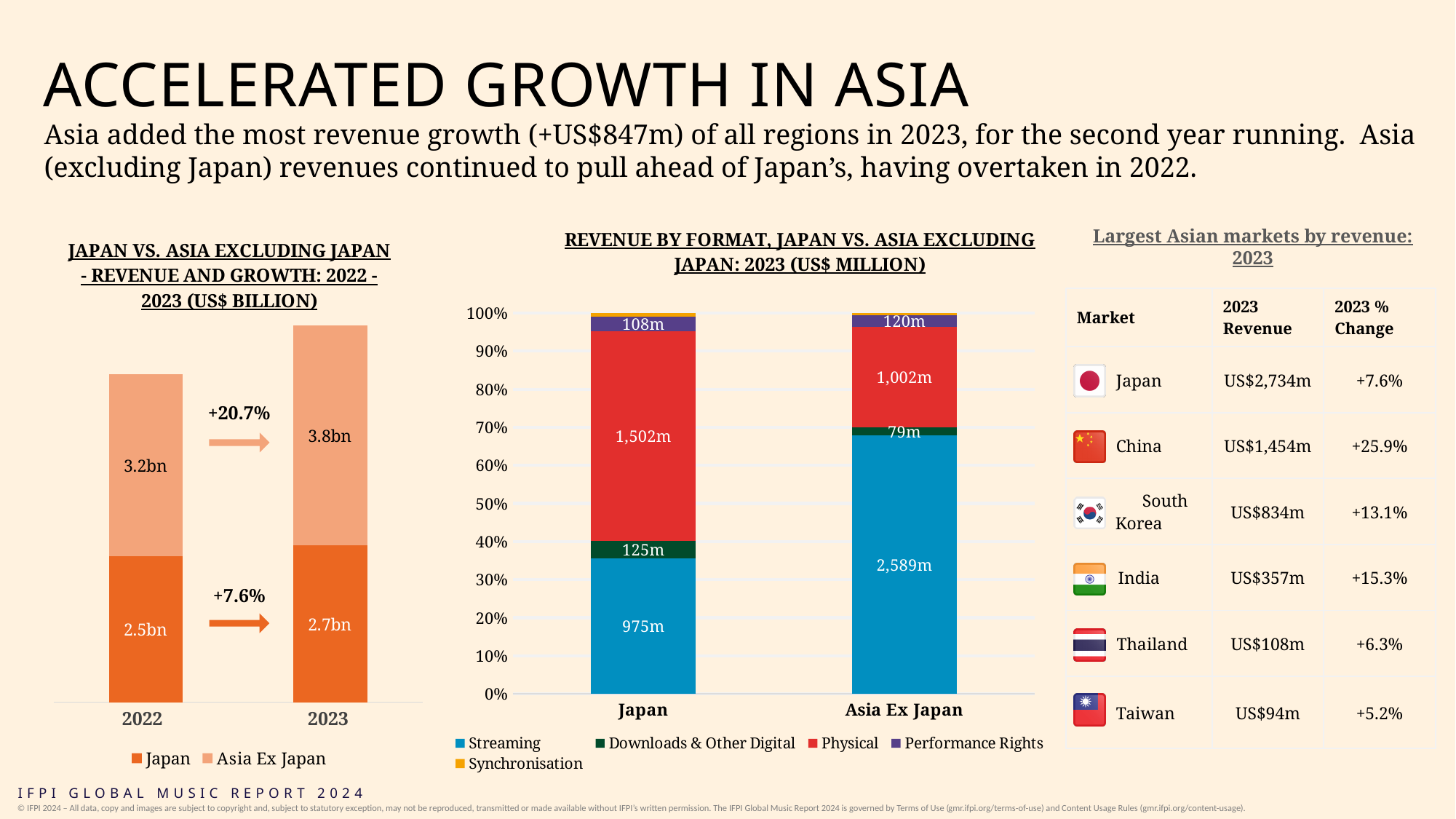
In the middle chart (Revenue by format), what is the Streaming value for Japan? 975m In the middle chart, what is the difference between the Streaming values for Asia Ex Japan and Japan? 1,614m How many series does the legend of the left chart list? 2 In the left chart, which series has the larger value in 2023, Japan or Asia Ex Japan? Asia Ex Japan In the left chart, by how much did Asia Ex Japan revenue increase from 2022 to 2023? 0.6bn In the left chart, what growth percentage is shown for Japan between 2022 and 2023? +7.6% How many series does the legend of the middle chart (Revenue by format) list? 5 In the left chart, what is the total of the stacked bar for 2023? 6.5bn In the left chart (Japan vs. Asia excluding Japan revenue), what is the value for Asia Ex Japan in 2023? 3.8bn In the left chart (Japan vs. Asia excluding Japan revenue), what is the value for Japan in 2022? 2.5bn In the middle chart (Revenue by format), what is the Physical value for Asia Ex Japan? 1,002m What kind of chart is the left chart (Japan vs. Asia excluding Japan revenue and growth)? Stacked bar chart